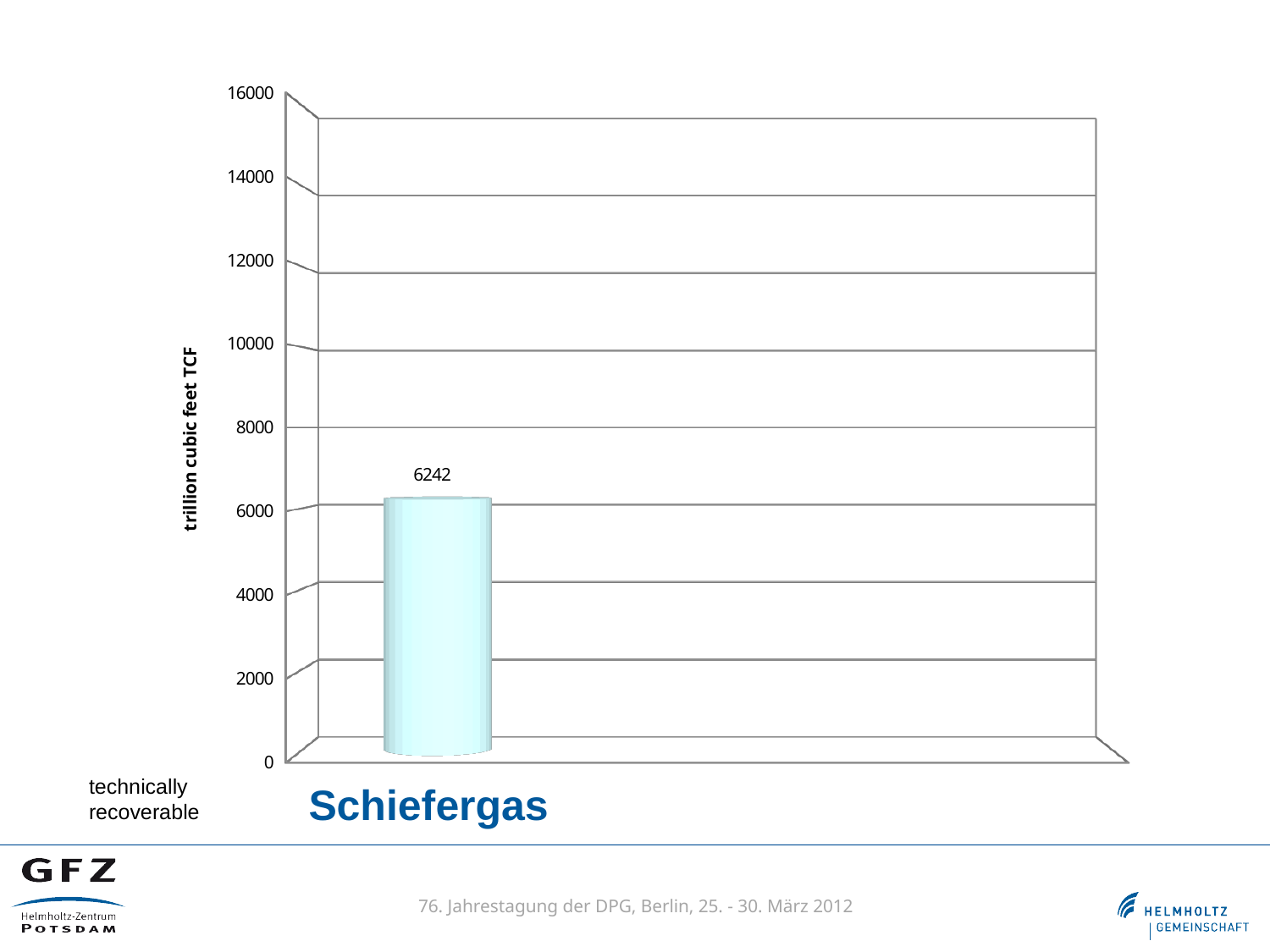
What is the label on the vertical axis of the chart? trillion cubic feet TCF What is the highest value shown on the vertical axis? 16000 Is the value for Schiefergas greater or less than 8000? less How many bars are plotted in the chart? 1 What kind of chart is shown on the slide? bar chart Is the value for Schiefergas greater or less than 6000? greater What is the value shown for Schiefergas? 6242 What is the category label of the bar in the chart? Schiefergas